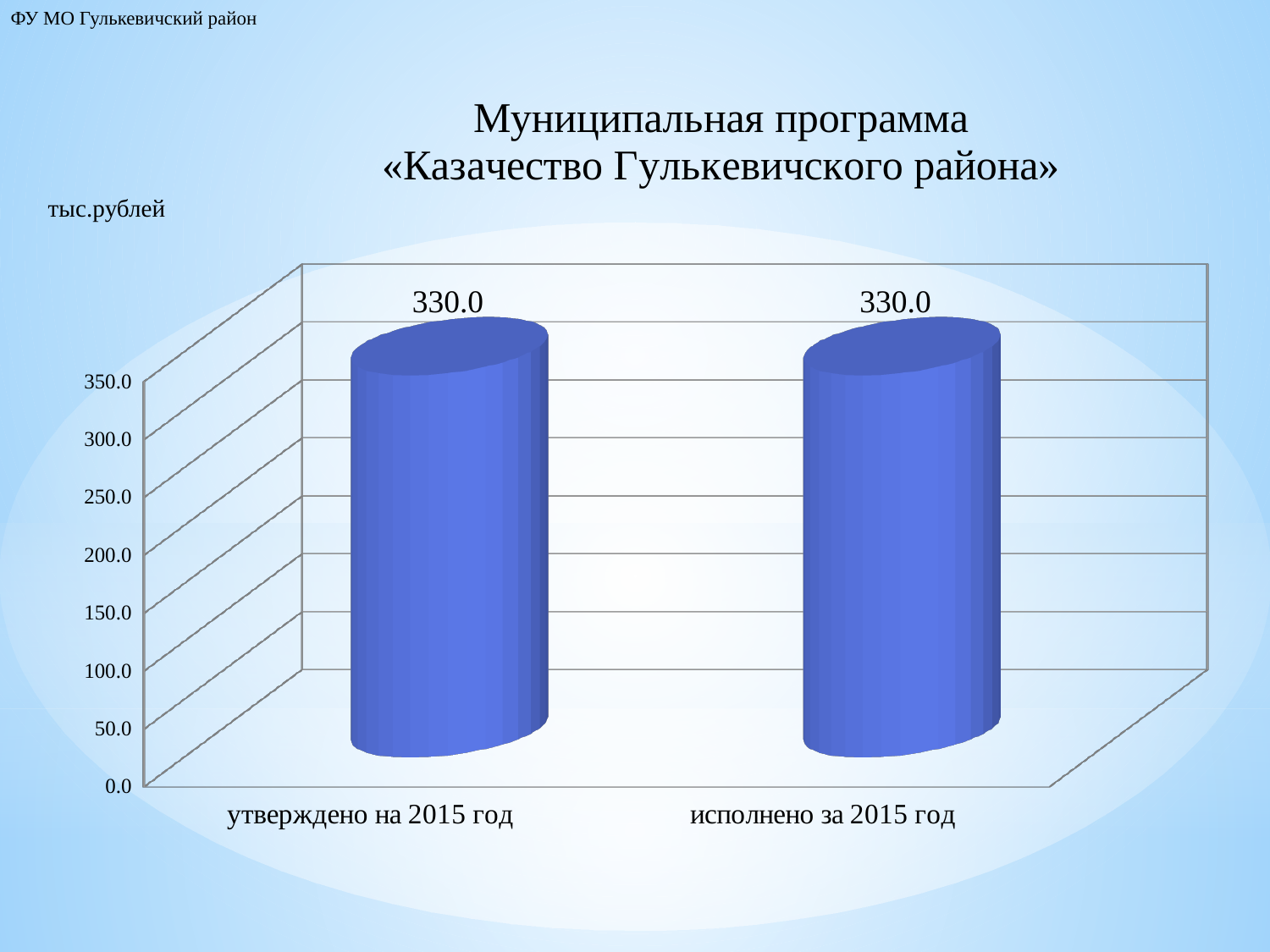
Is the value for «утверждено на 2015 год» greater or less than 350.0? less Is the value for «исполнено за 2015 год» greater or less than 300.0? greater Do the values rise, fall or stay the same from «утверждено на 2015 год» to «исполнено за 2015 год»? stay the same Are the values for «утверждено на 2015 год» and «исполнено за 2015 год» equal? yes What is the value for «утверждено на 2015 год»? 330.0 What is the difference between the value for «утверждено на 2015 год» and the value for «исполнено за 2015 год»? 0.0 What is the title of the chart? Муниципальная программа «Казачество Гулькевичского района» In what units are the values on the chart given? тыс.рублей What kind of chart is shown on the slide? bar chart How many categories are shown on the chart? 2 What is the value for «исполнено за 2015 год»? 330.0